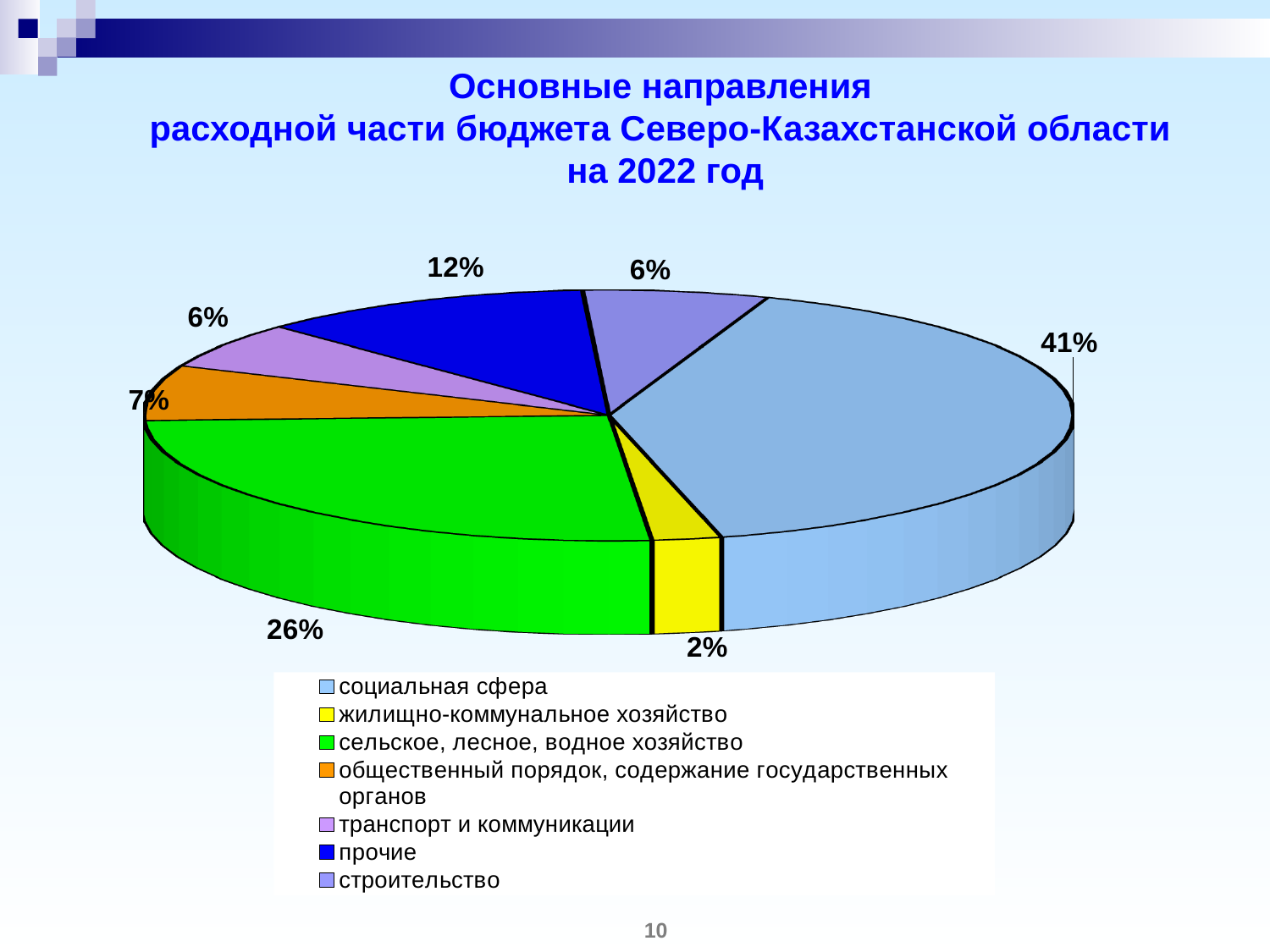
What share of the budget expenditure goes to жилищно-коммунальное хозяйство? 2% Which category has the largest share of the budget expenditure? социальная сфера How many categories does the pie chart show? 7 What share of the budget expenditure goes to сельское, лесное, водное хозяйство? 26% What share of the budget expenditure goes to общественный порядок, содержание государственных органов? 7% Which is larger, the share for прочие or the share for транспорт и коммуникации? прочие Which category has the smallest share of the budget expenditure? жилищно-коммунальное хозяйство What is the difference in percentage points between социальная сфера and сельское, лесное, водное хозяйство? 15 Which year does the chart title refer to? 2022 What kind of chart is shown on the slide? pie chart